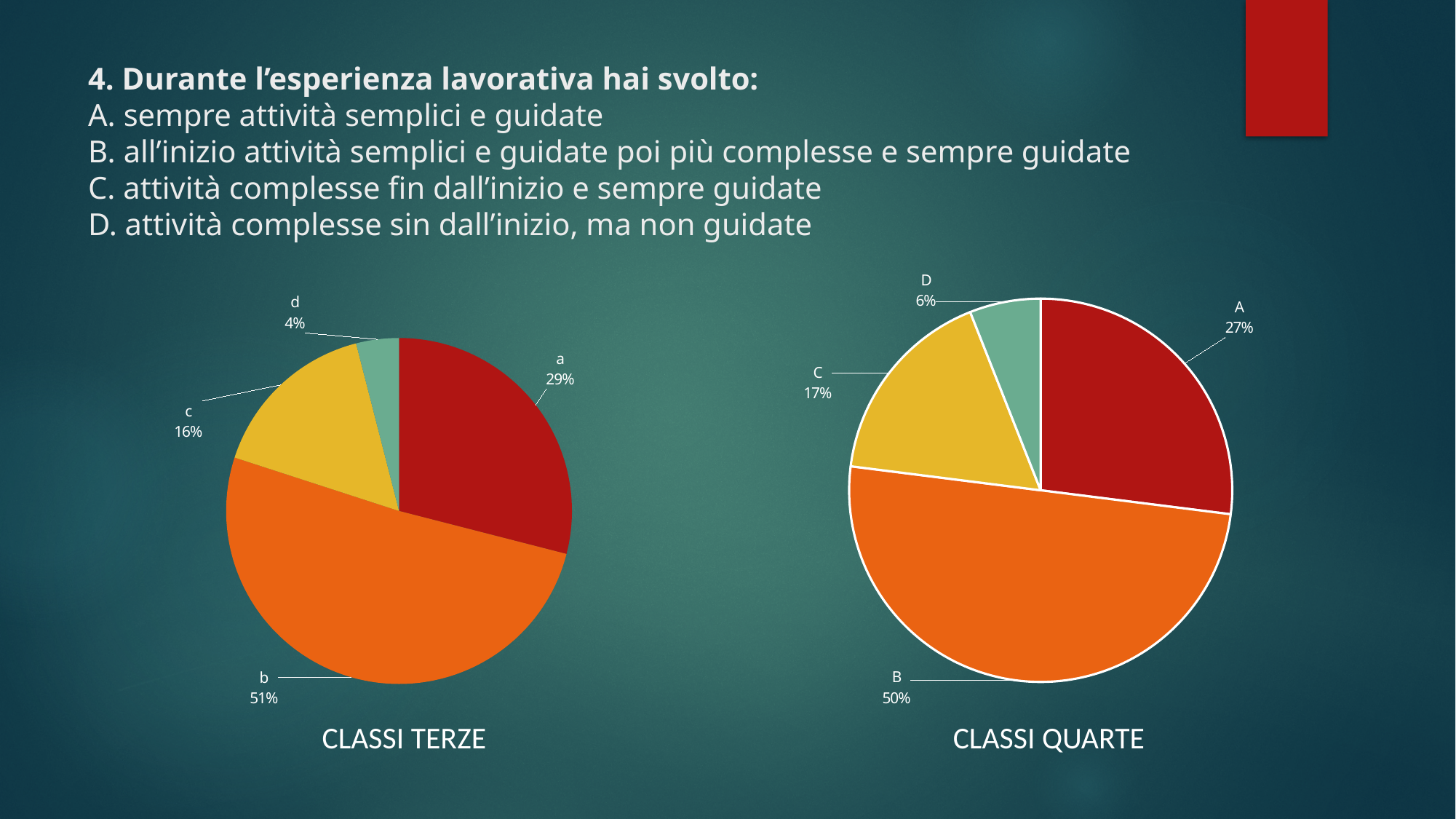
In the CLASSI QUARTE chart, what is the difference in percentage points between slice B and slice A? 23 Which is larger: slice a in the CLASSI TERZE chart or slice A in the CLASSI QUARTE chart? slice a in CLASSI TERZE In the CLASSI QUARTE chart, which slice is the smallest? D In the CLASSI TERZE chart, what percentage is shown for slice b? 51% In the CLASSI QUARTE chart, what percentage is shown for slice C? 17% In the CLASSI TERZE chart, what is the difference in percentage points between slice a and slice c? 13 What colour is slice B in the CLASSI QUARTE chart? orange In the CLASSI QUARTE chart, what percentage is shown for slice A? 27% How many slices does the CLASSI QUARTE chart have? 4 What type of chart is the CLASSI TERZE chart? pie chart In the CLASSI TERZE chart, which slice is the largest? b In the CLASSI TERZE chart, what percentage is shown for slice d? 4%